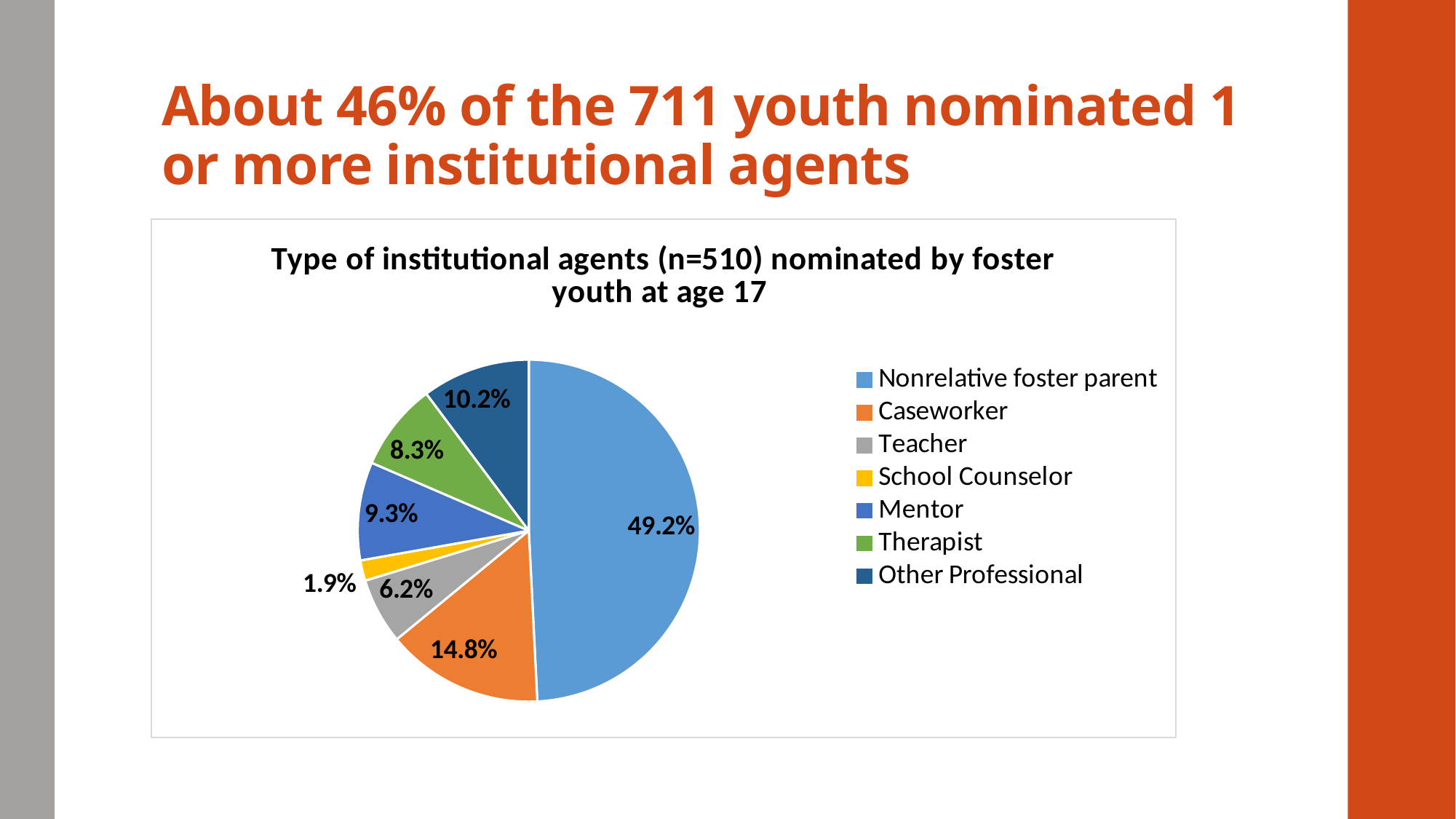
Which category has the largest share of the pie? Nonrelative foster parent What type of chart is shown on the slide? Pie chart What is the value for Teacher? 6.2% What is the value for Mentor? 9.3% Which category has the smallest share of the pie? School Counselor What is the title of the chart? Type of institutional agents (n=510) nominated by foster youth at age 17 How many categories does the pie chart have? 7 What is the difference between the Caseworker and Therapist shares? 6.5% Which is larger, the share for Mentor or the share for Therapist? Mentor What share of the pie does Nonrelative foster parent represent? 49.2% What is the value for Caseworker? 14.8% What is the value for Other Professional? 10.2%